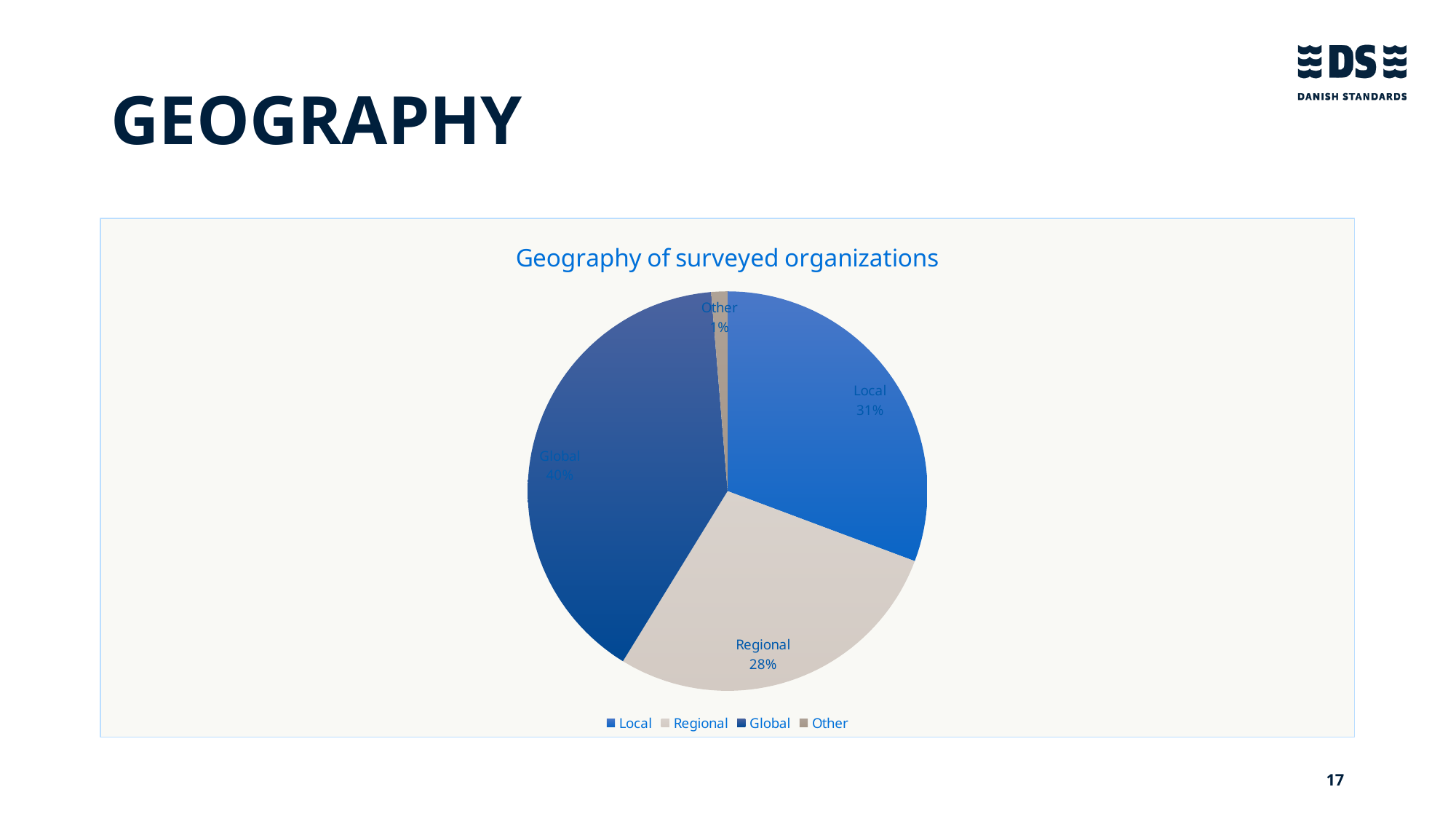
What is the title of the chart? Geography of surveyed organizations What share of surveyed organizations is Global? 40% What is the difference in percentage points between the Global and Regional shares? 12 What share of surveyed organizations is Regional? 28% What type of chart is shown on the slide? pie chart How many entries does the legend list? 4 What share of surveyed organizations is Other? 1% Which is larger, the Local share or the Regional share? Local What share of surveyed organizations is Local? 31% Which category has the largest share of the pie? Global Which category has the smallest share of the pie? Other How many categories does the pie chart show? 4